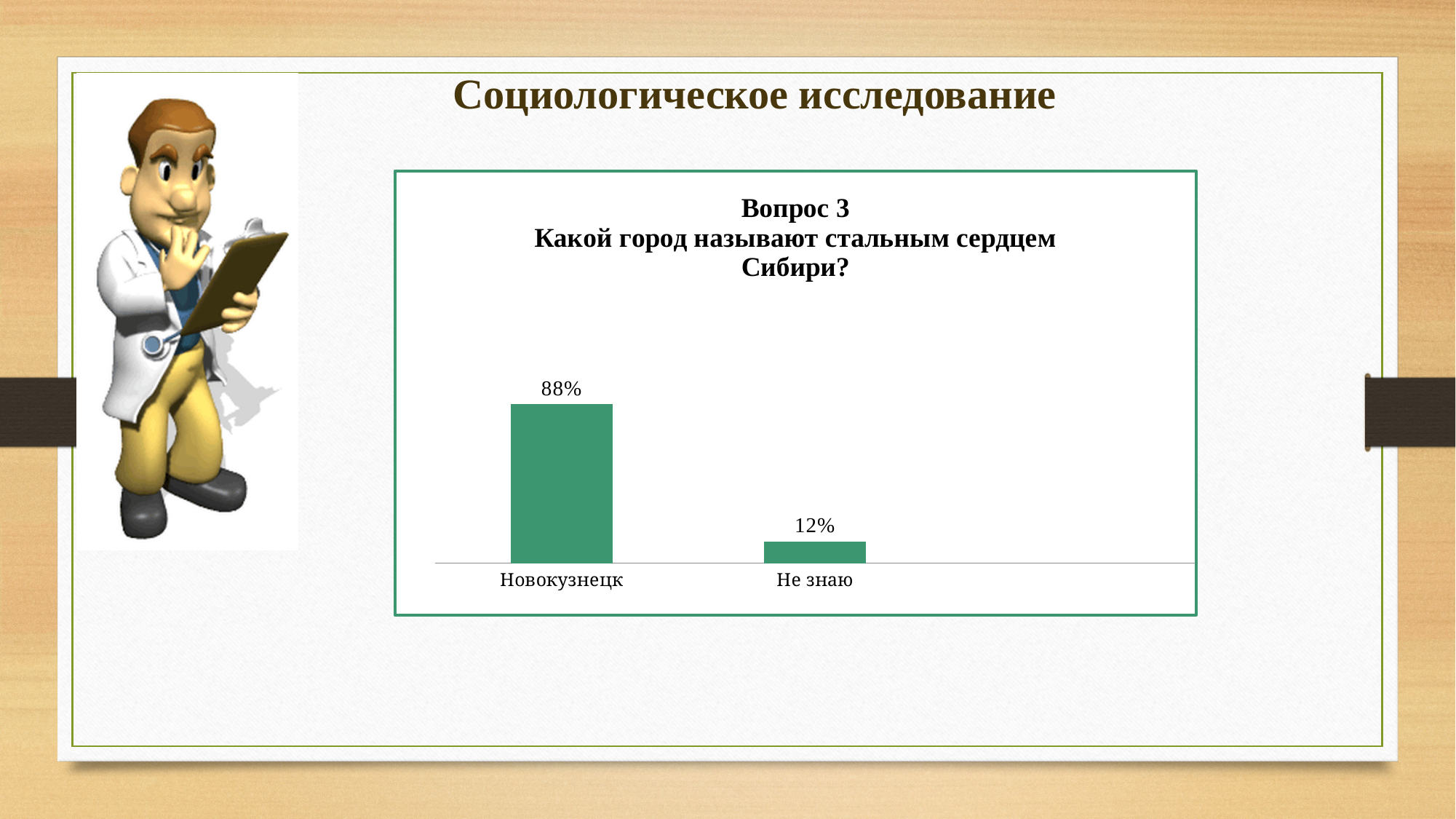
What kind of chart is shown on the slide? Bar chart Which category has the highest value? Новокузнецк How many categories are shown in the chart? 2 What colour are the bars in the chart? Green What is the difference between the values for Новокузнецк and Не знаю? 76% Which category has the lowest value? Не знаю What is the value for Новокузнецк? 88% What is the total of the two values shown in the chart? 100% Which is larger, the value for Новокузнецк or the value for Не знаю? Новокузнецк What is the value for Не знаю? 12% What is the title of the chart? Вопрос 3 Какой город называют стальным сердцем Сибири?